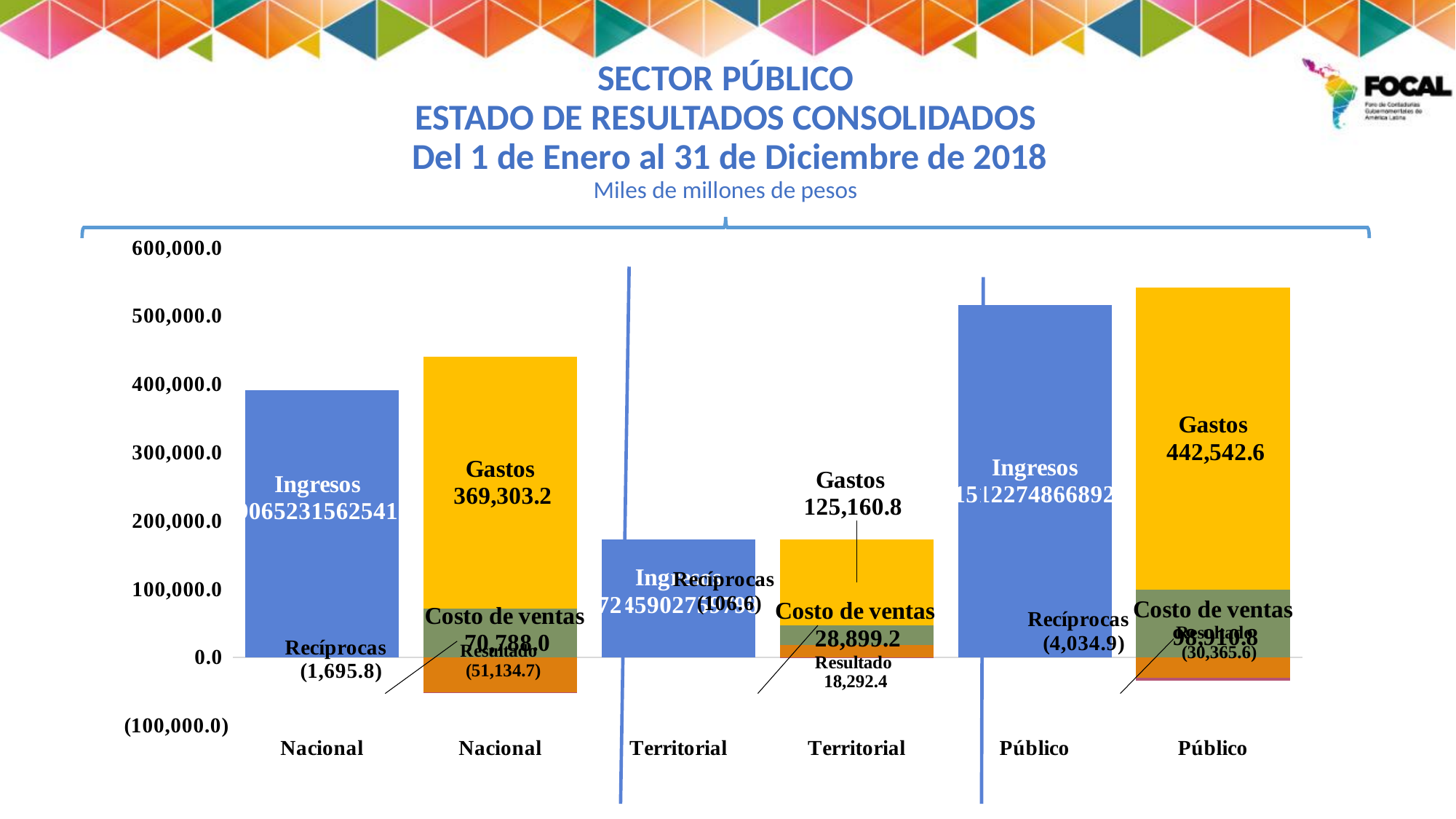
Which is larger, the Gastos value for Nacional or for Territorial? Nacional What is the value of Gastos for the Nacional sector? 369,303.2 What is the value of Recíprocas for the Público sector? (4,034.9) Is the Ingresos bar for the Territorial sector greater or less than 200,000.0? less Which sector has the highest Gastos value? Público What kind of chart is shown on the slide? bar chart What is the value of Resultado for the Territorial sector? 18,292.4 What is the value of Resultado for the Nacional sector? (51,134.7) What is the difference between the Gastos values for Público and Nacional? 73,239.4 What is the value of Gastos for the Territorial sector? 125,160.8 What is the value of Costo de ventas for the Nacional sector? 70,788.0 What is the value of Gastos for the Público sector? 442,542.6